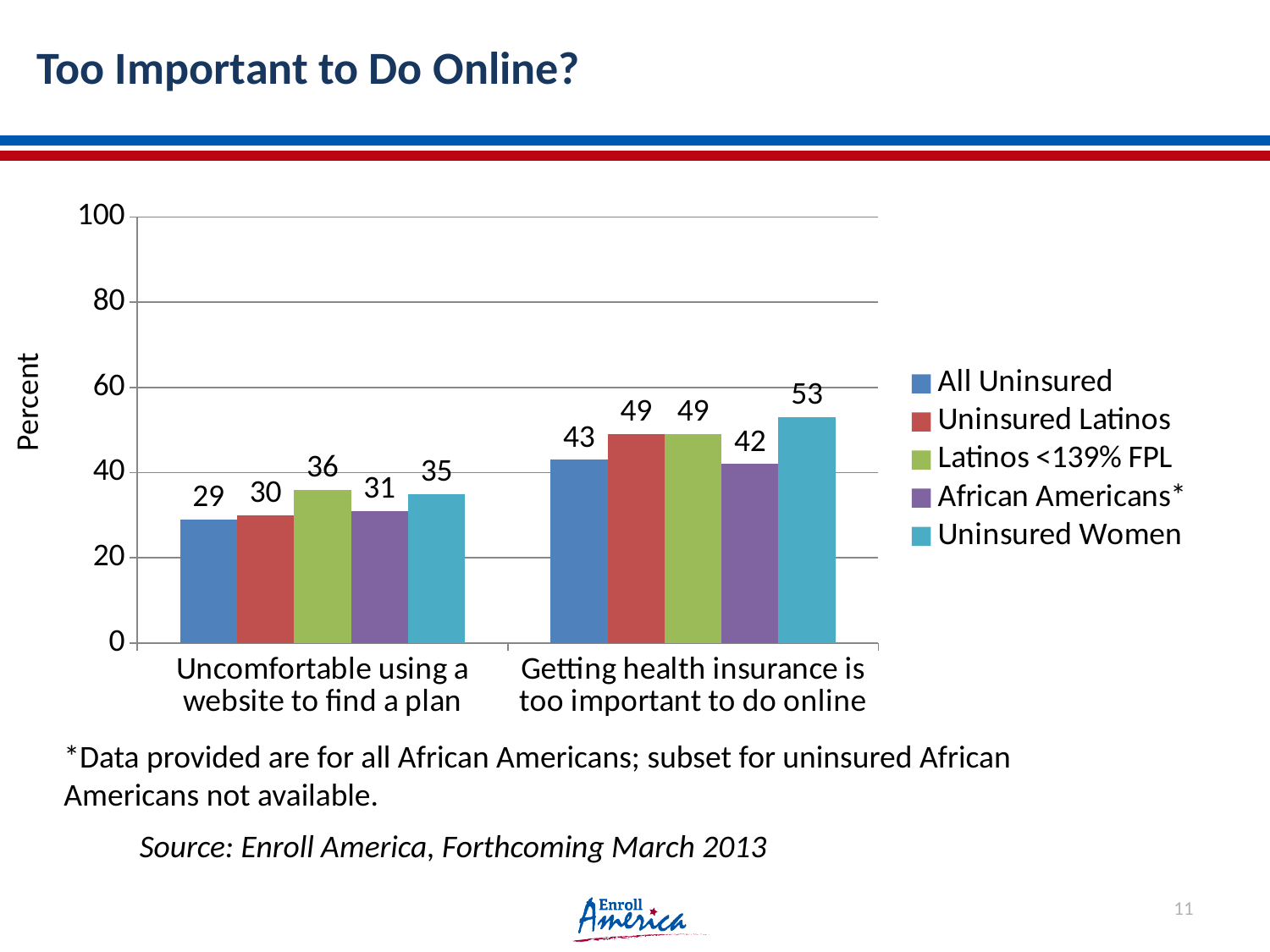
What is the value for All Uninsured in the 'Uncomfortable using a website to find a plan' category? 29 Which series has the lowest value in the 'Uncomfortable using a website to find a plan' category? All Uninsured How many categories are shown on the x axis? 2 What is the value for Uninsured Women in the 'Getting health insurance is too important to do online' category? 53 What is the value for Latinos <139% FPL in the 'Uncomfortable using a website to find a plan' category? 36 Which series has the highest value in the 'Getting health insurance is too important to do online' category? Uninsured Women How many series does the legend list? 5 Which is larger: the Uninsured Latinos value for 'Uncomfortable using a website to find a plan' or for 'Getting health insurance is too important to do online'? Getting health insurance is too important to do online What is the label of the y axis? Percent What is the difference between the Uninsured Women value and the African Americans* value in the 'Getting health insurance is too important to do online' category? 11 What kind of chart is shown on the slide? Bar chart Is the value for All Uninsured in the 'Getting health insurance is too important to do online' category greater or less than 40? greater